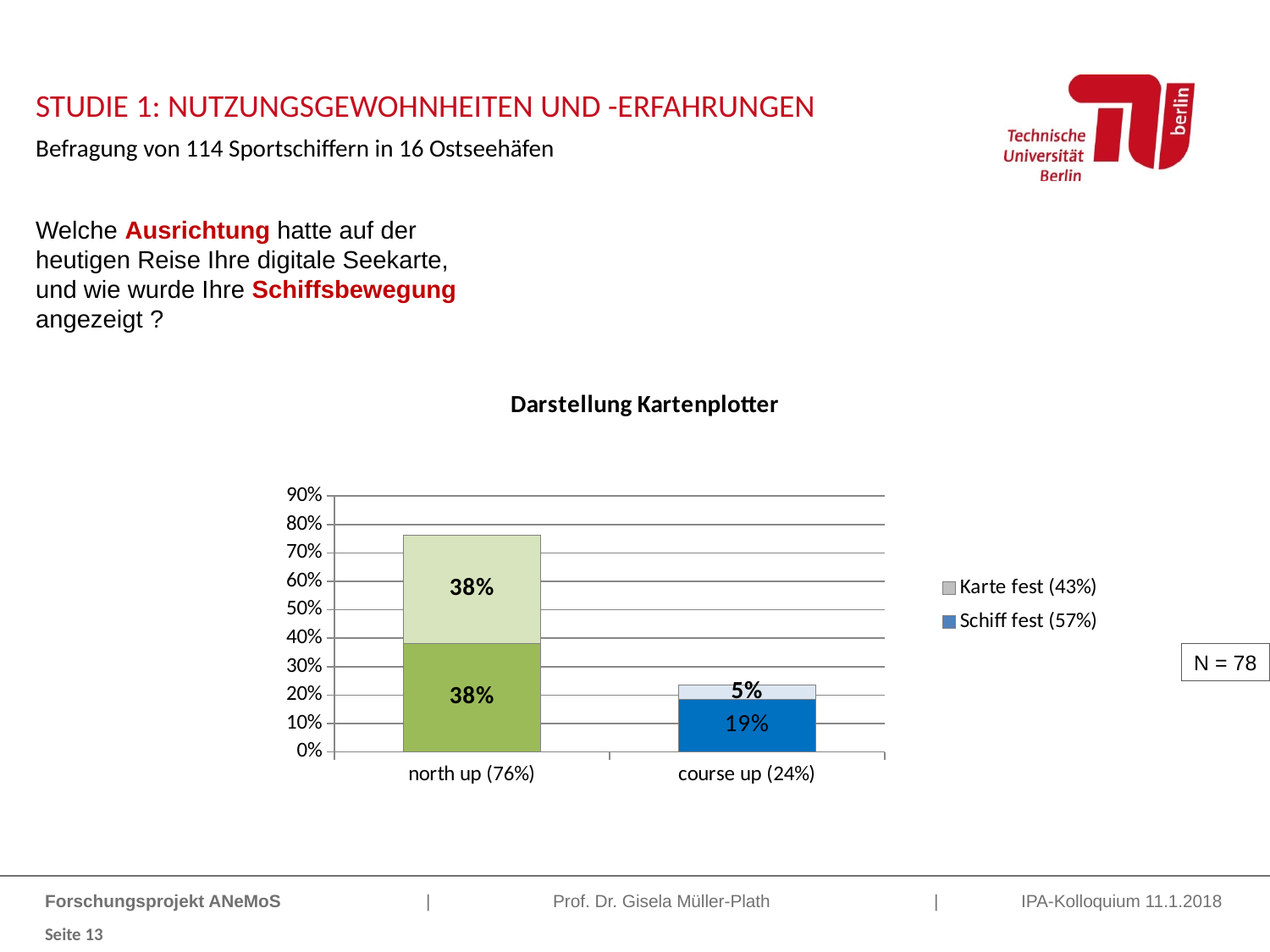
What is the value of Karte fest for course up (24%)? 5% Which category has the higher total stacked bar, north up (76%) or course up (24%)? north up (76%) What is the value of Schiff fest for course up (24%)? 19% What is the title of the chart? Darstellung Kartenplotter How many series does the chart legend list? 2 What is the total of the stacked bar for course up (24%)? 24% Which legend entry is shown in blue? Schiff fest (57%) What is the value of Karte fest for north up (76%)? 38% What kind of chart is shown on the slide? stacked bar chart How many categories are shown on the x axis of the chart? 2 What is the value of Schiff fest for north up (76%)? 38% What is the difference between the Schiff fest values for north up (76%) and course up (24%)? 19%